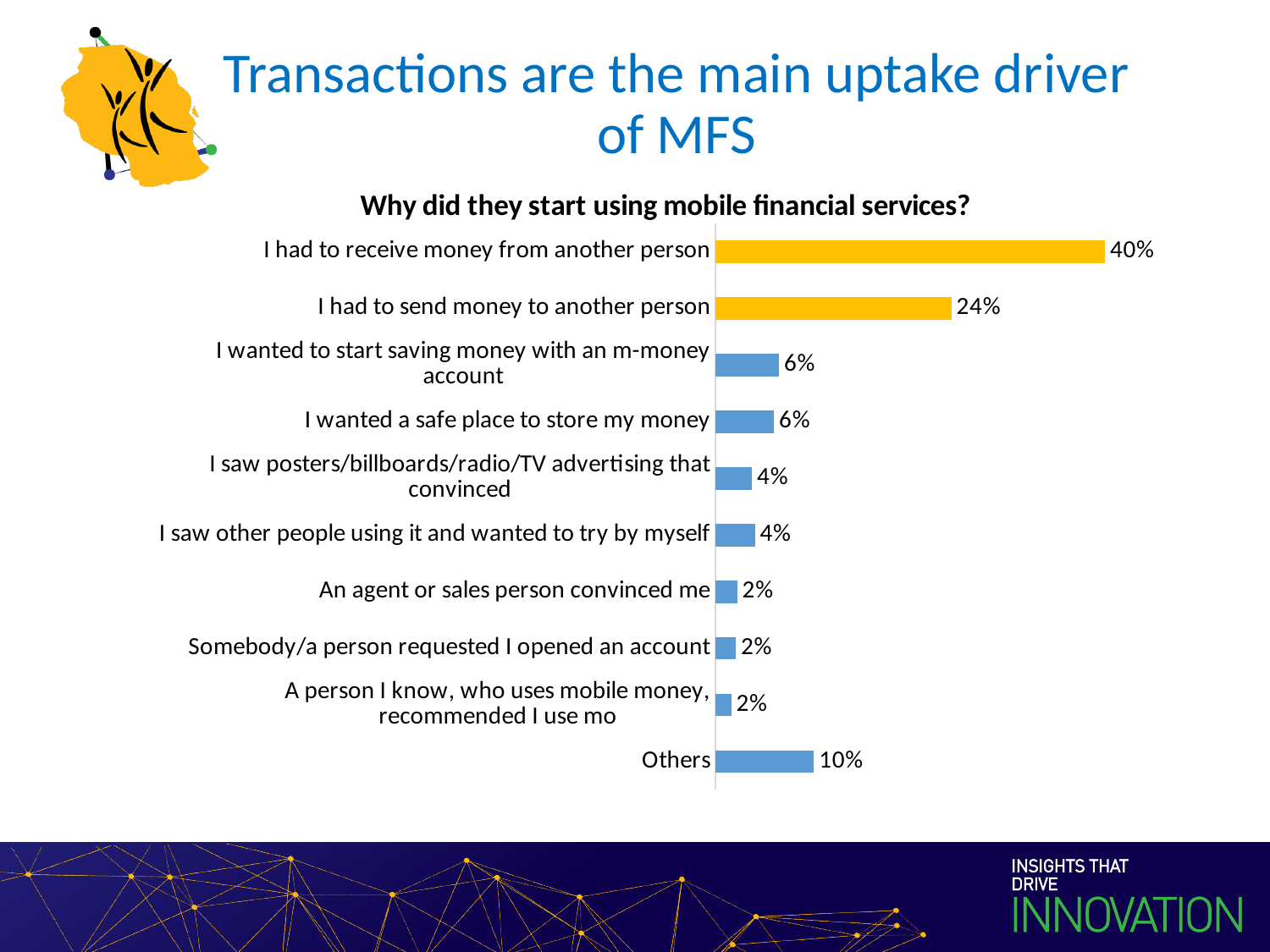
How many bars are coloured yellow rather than blue? 2 What is the value for "I had to send money to another person"? 24% What is the value for "An agent or sales person convinced me"? 2% What is the value for "Others"? 10% Which reason has the highest percentage? I had to receive money from another person What is the combined value of "I had to receive money from another person" and "I had to send money to another person"? 64% Which is larger: the value for "Others" or the value for "I wanted a safe place to store my money"? Others How many categories (reasons) are shown in the chart? 10 What is the title of the chart? Why did they start using mobile financial services? What is the difference between the values for "I had to receive money from another person" and "I had to send money to another person"? 16% What percentage of respondents said they started using mobile financial services because they had to receive money from another person? 40% What kind of chart is shown on the slide? Bar chart